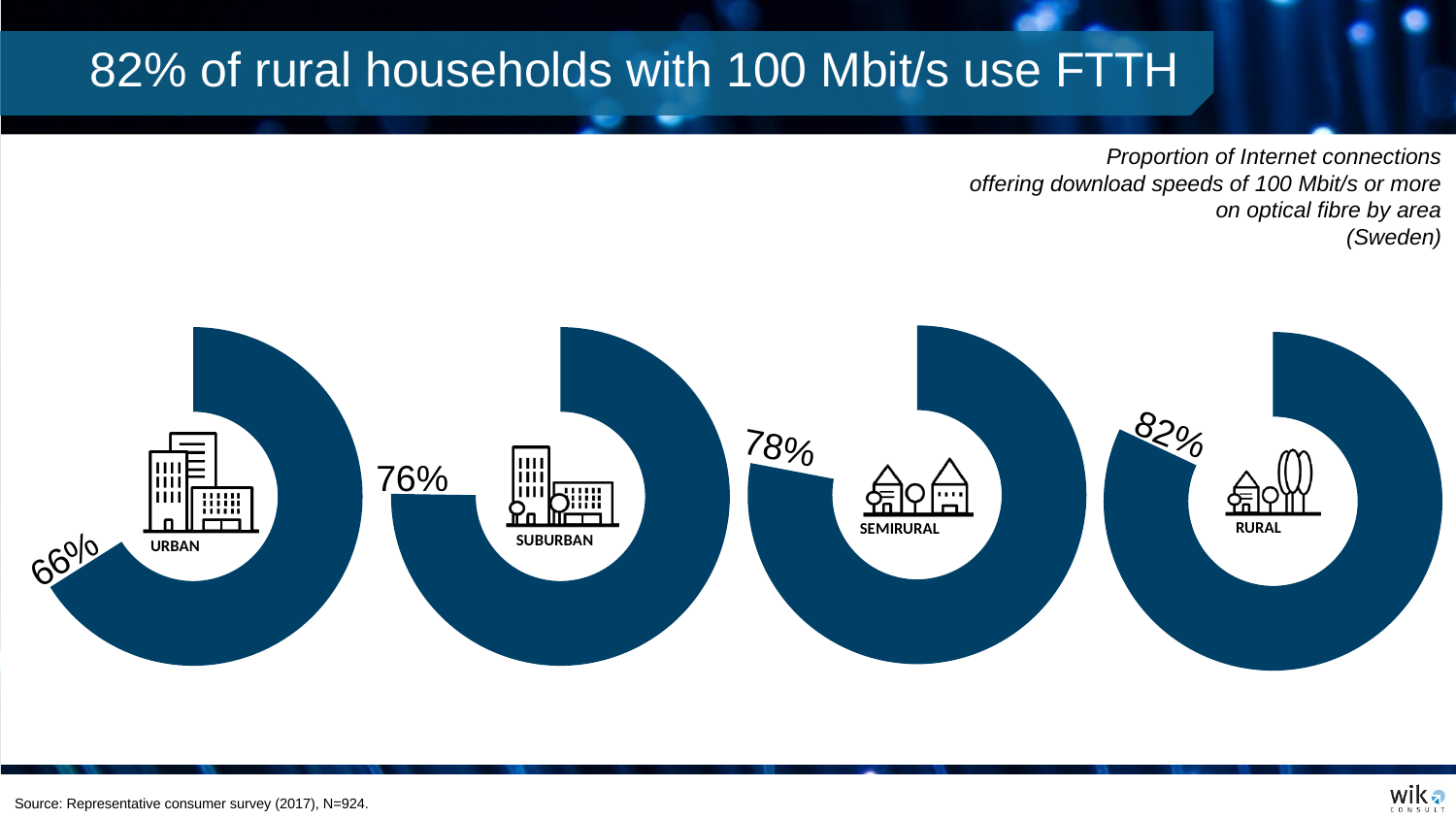
In the Rural donut chart, what value is shown? 82% What kind of chart is used to show the value for each area on the slide? Donut chart Across the four donut charts, which area has the lowest proportion of 100 Mbit/s connections on optical fibre? Urban In the Semirural donut chart, what value is shown? 78% Comparing the Suburban and Semirural donut charts, which area has the larger value? Semirural How many area categories are shown as donut charts on the slide? 4 Reading the donut charts from left to right (Urban to Rural), do the values rise or fall? Rise In the Urban donut chart, what percentage of Internet connections with 100 Mbit/s or more are on optical fibre? 66% Comparing the Semirural and Suburban donut charts, what is the difference between their values? 2 percentage points Across the four donut charts, which area has the highest proportion of 100 Mbit/s connections on optical fibre? Rural In the Suburban donut chart, what value is shown? 76% Comparing the Rural and Urban donut charts, what is the difference in percentage points between their values? 16 percentage points